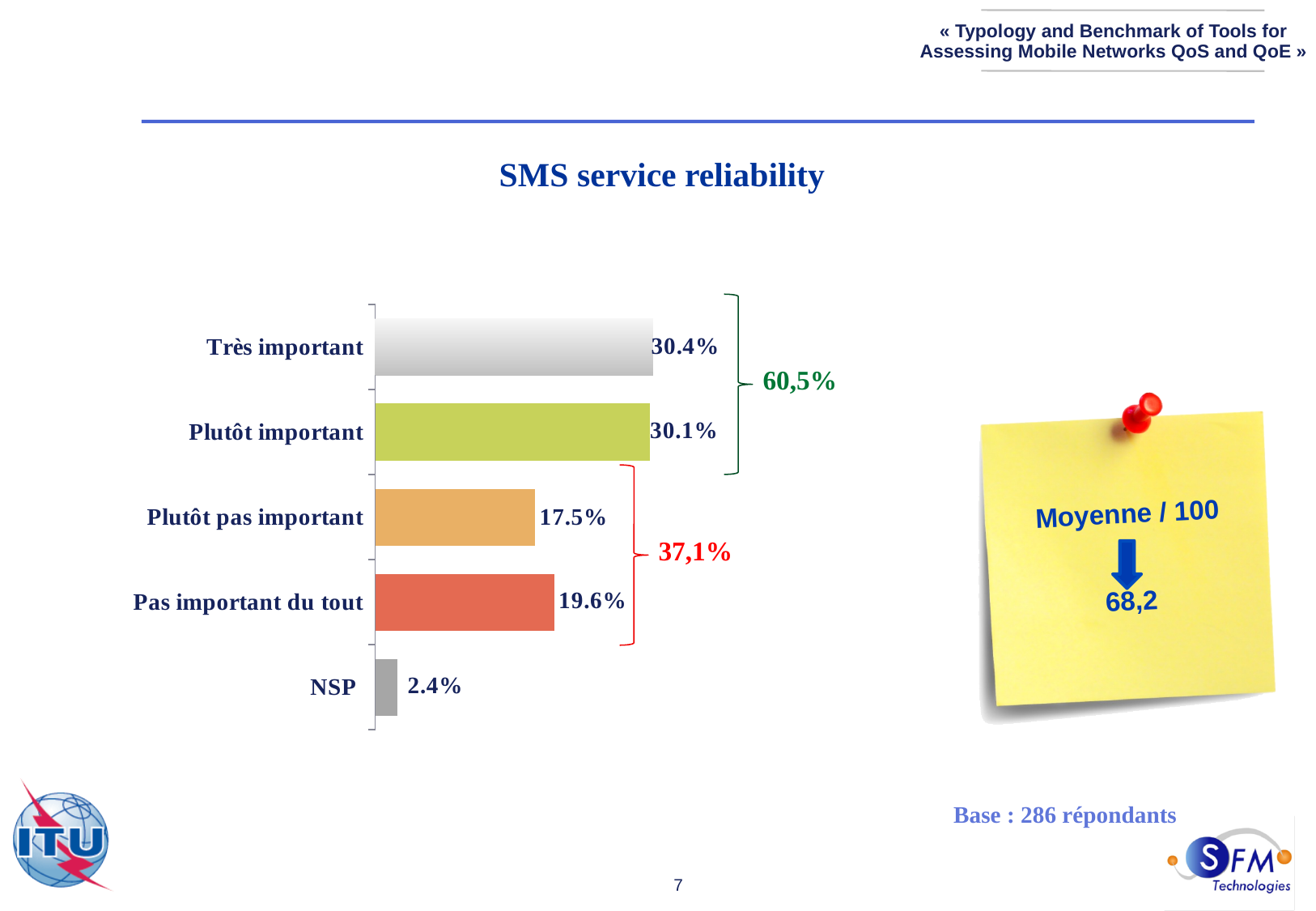
What kind of chart is shown on the slide? Bar chart What is the value for "Plutôt pas important"? 17.5% What is the value for "Très important"? 30.4% Which is larger, the value for "Pas important du tout" or the value for "Plutôt pas important"? Pas important du tout What is the value for "NSP"? 2.4% How many categories are plotted in the chart? 5 What is the difference between the values for "Pas important du tout" and "Plutôt pas important"? 2.1% What is the value for "Pas important du tout"? 19.6% Which category has the highest value? Très important What is the title of the chart? SMS service reliability Which category has the lowest value? NSP What is the value for "Plutôt important"? 30.1%